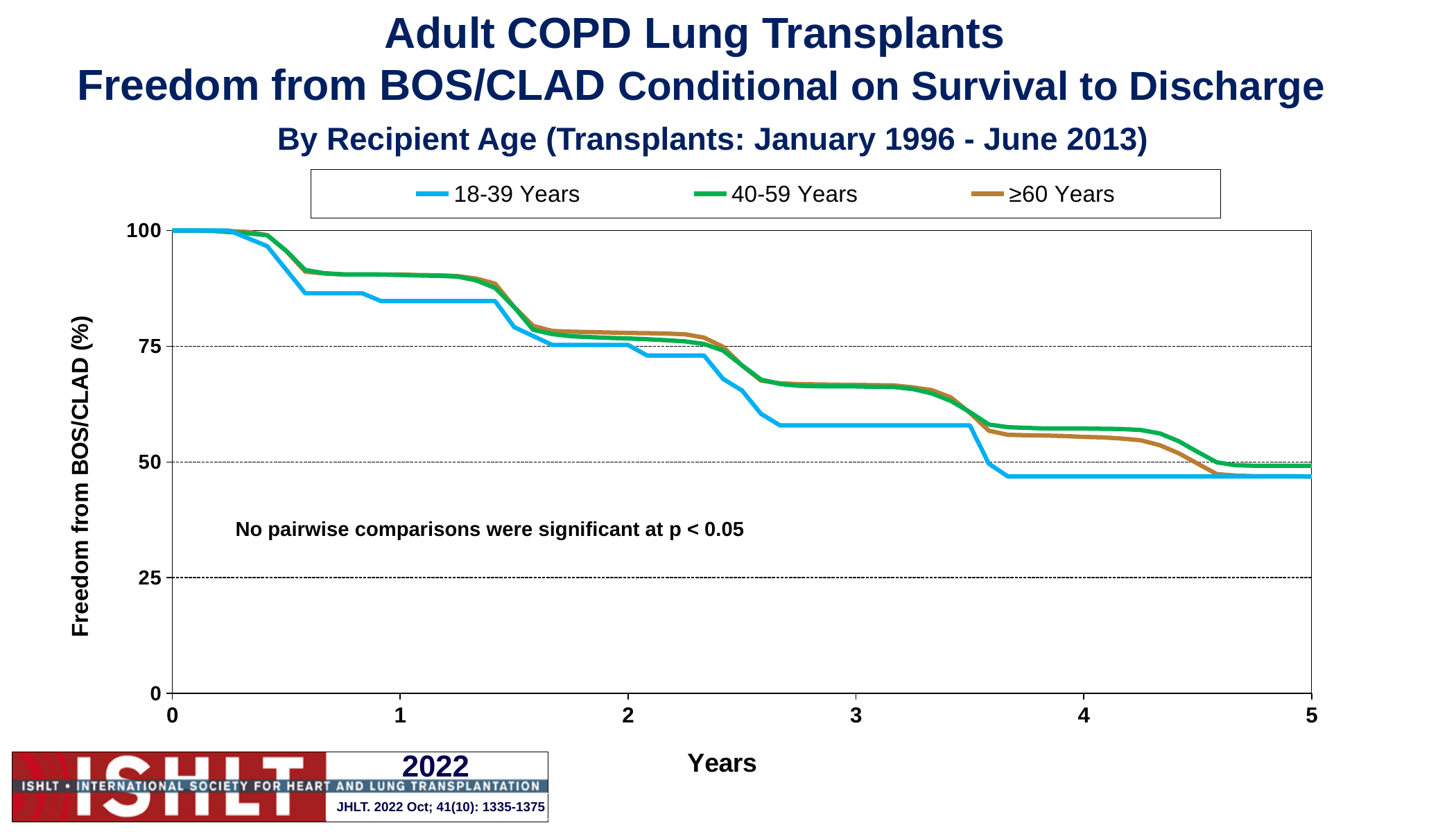
Is the value for 18-39 Years at year 3 greater or less than 50? greater Do the values for the 18-39 Years series rise or fall as years increase? fall Which series has the lowest value at year 3? 18-39 Years Which age groups are listed in the legend? 18-39 Years, 40-59 Years, ≥60 Years Is the value for 40-59 Years at year 1 greater or less than 75? greater Is the value for 40-59 Years at year 4 greater or less than 50? greater At year 4, which is higher: 40-59 Years or 18-39 Years? 40-59 Years What is the label of the y axis? Freedom from BOS/CLAD (%) What kind of chart is shown on the slide? line chart How many series does the legend list? 3 At year 3, which is higher: 40-59 Years or 18-39 Years? 40-59 Years